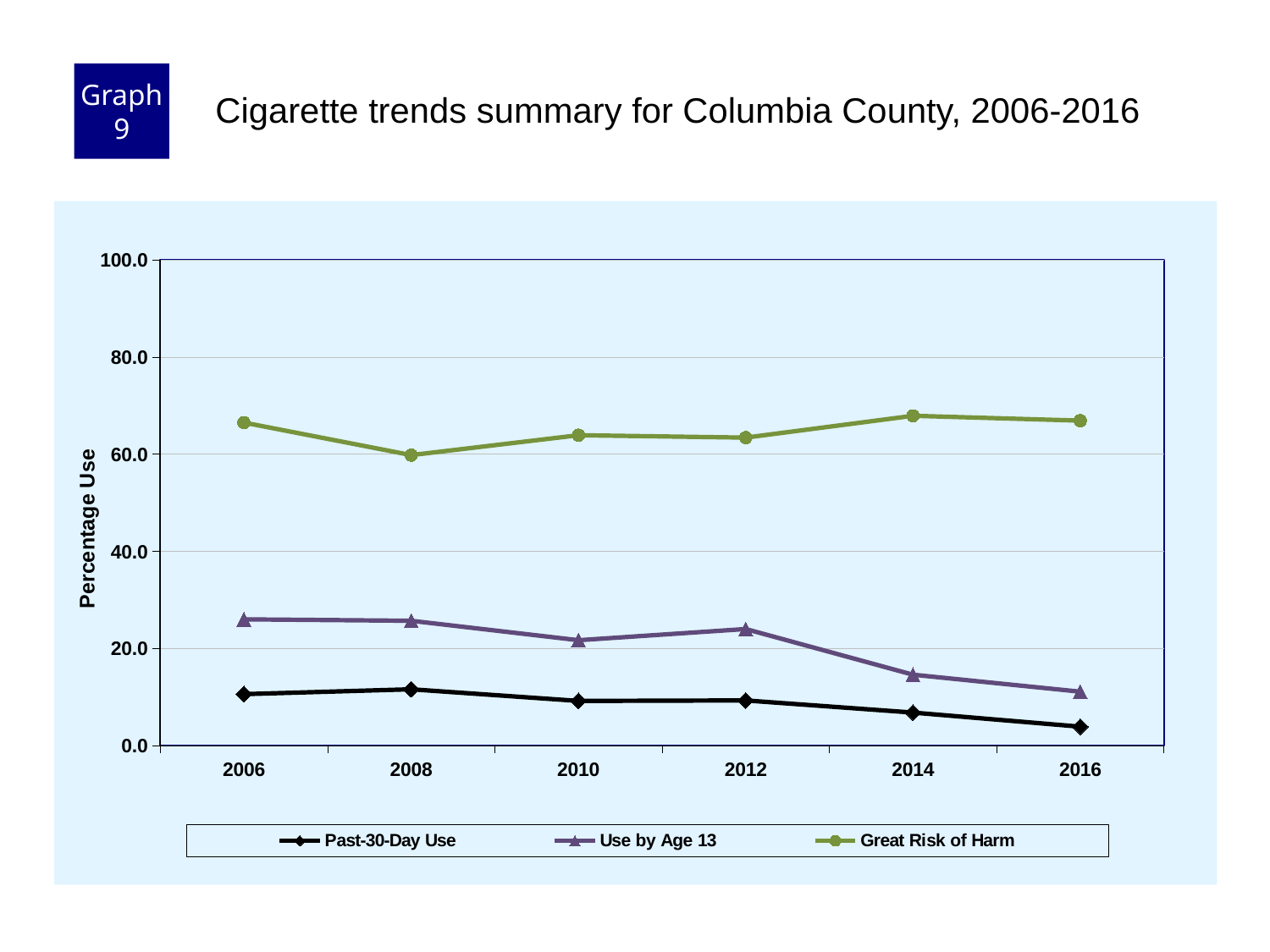
In which year is the Past-30-Day Use series at its lowest? 2016 What is the label on the y axis? Percentage Use In which year is the Great Risk of Harm series at its lowest? 2008 What kind of chart is shown on the slide? Line chart In which year is the Use by Age 13 series at its lowest? 2016 What is the title of the chart? Cigarette trends summary for Columbia County, 2006-2016 Is the value for Use by Age 13 in 2016 greater or less than 20? less Does the Past-30-Day Use series rise or fall overall from 2006 to 2016? Fall How many series does the legend list? 3 Which is larger in 2012: Great Risk of Harm or Use by Age 13? Great Risk of Harm Is the value for Great Risk of Harm in 2014 greater or less than 60? greater How many years are plotted along the x axis? 6